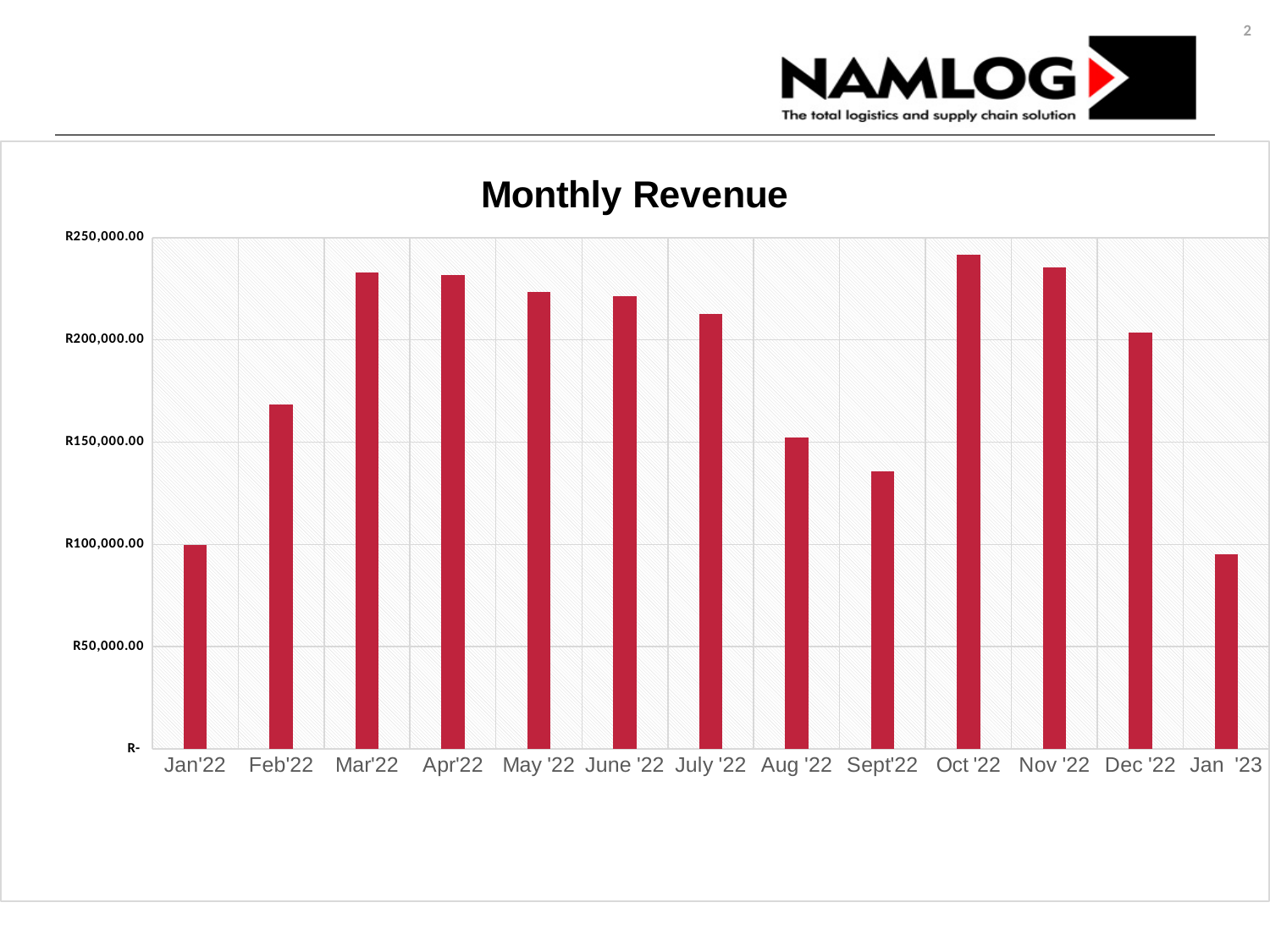
What is the title of the chart? Monthly Revenue Which month has the larger revenue, Mar'22 or Feb'22? Mar'22 Which month has the larger revenue, Oct '22 or Sept'22? Oct '22 Is the revenue for Sept'22 greater or less than R150,000.00? less Which month has the larger revenue, Nov '22 or Dec '22? Nov '22 How many months are plotted on the x axis of the Monthly Revenue chart? 13 Do the revenue values rise or fall from Mar'22 through Sept'22? fall What kind of chart is shown on the slide? bar chart Which month has the highest revenue in the Monthly Revenue chart? Oct '22 Is the revenue for Mar'22 greater or less than R200,000.00? greater Is the revenue for Feb'22 greater or less than R150,000.00? greater